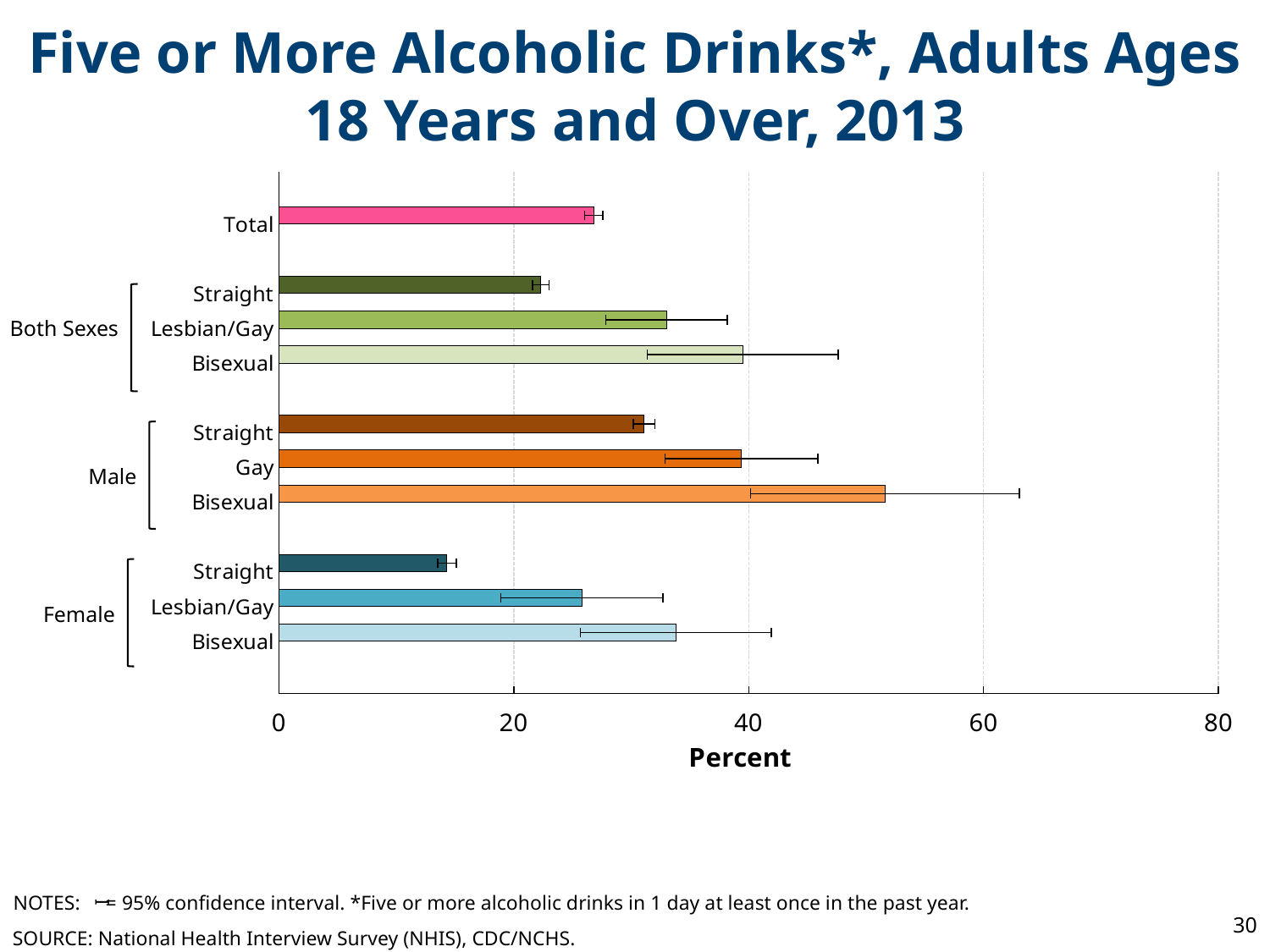
Which is larger, the value for Male Bisexual or the value for Female Bisexual? Male Bisexual What kind of chart is shown on the slide? bar chart Which is larger, the value for Male Straight or the value for Female Straight? Male Straight Which bar has the lowest value in the chart? Female Straight Is the value for Male Straight greater or less than 20? greater Is the value for Female Bisexual greater or less than 40? less Which is larger, the value for Both Sexes Lesbian/Gay or the value for Both Sexes Straight? Both Sexes Lesbian/Gay Which bar has the highest value in the chart? Male Bisexual Is the value for Female Straight greater or less than 20? less What is the label on the horizontal axis of the chart? Percent How many bars are plotted in the chart? 10